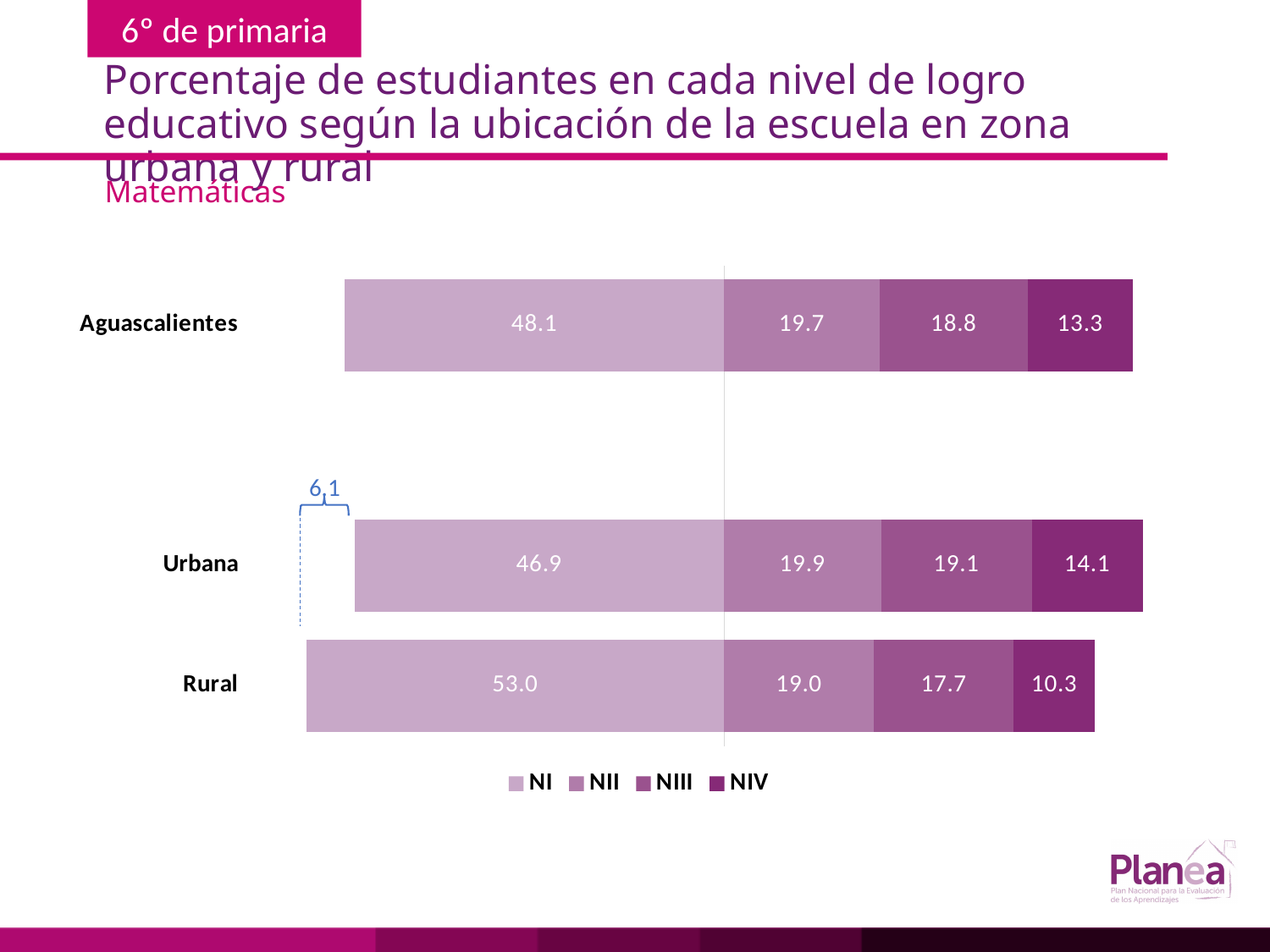
What is the NIV value for Urbana? 14.1 How many categories are shown on the chart? 3 What kind of chart is shown on the slide? Stacked bar chart What is the difference between the NI values for Rural and Urbana? 6.1 Which is larger, the NIII value for Aguascalientes or the NIII value for Rural? Aguascalientes What is the NII value for Rural? 19.0 Which category has the highest NI value? Rural What is the NI value for Aguascalientes? 48.1 How many series does the legend list? 4 Which category has the lowest NIV value? Rural What is the difference between the NIV values for Urbana and Rural? 3.8 What is the NIII value for Urbana? 19.1